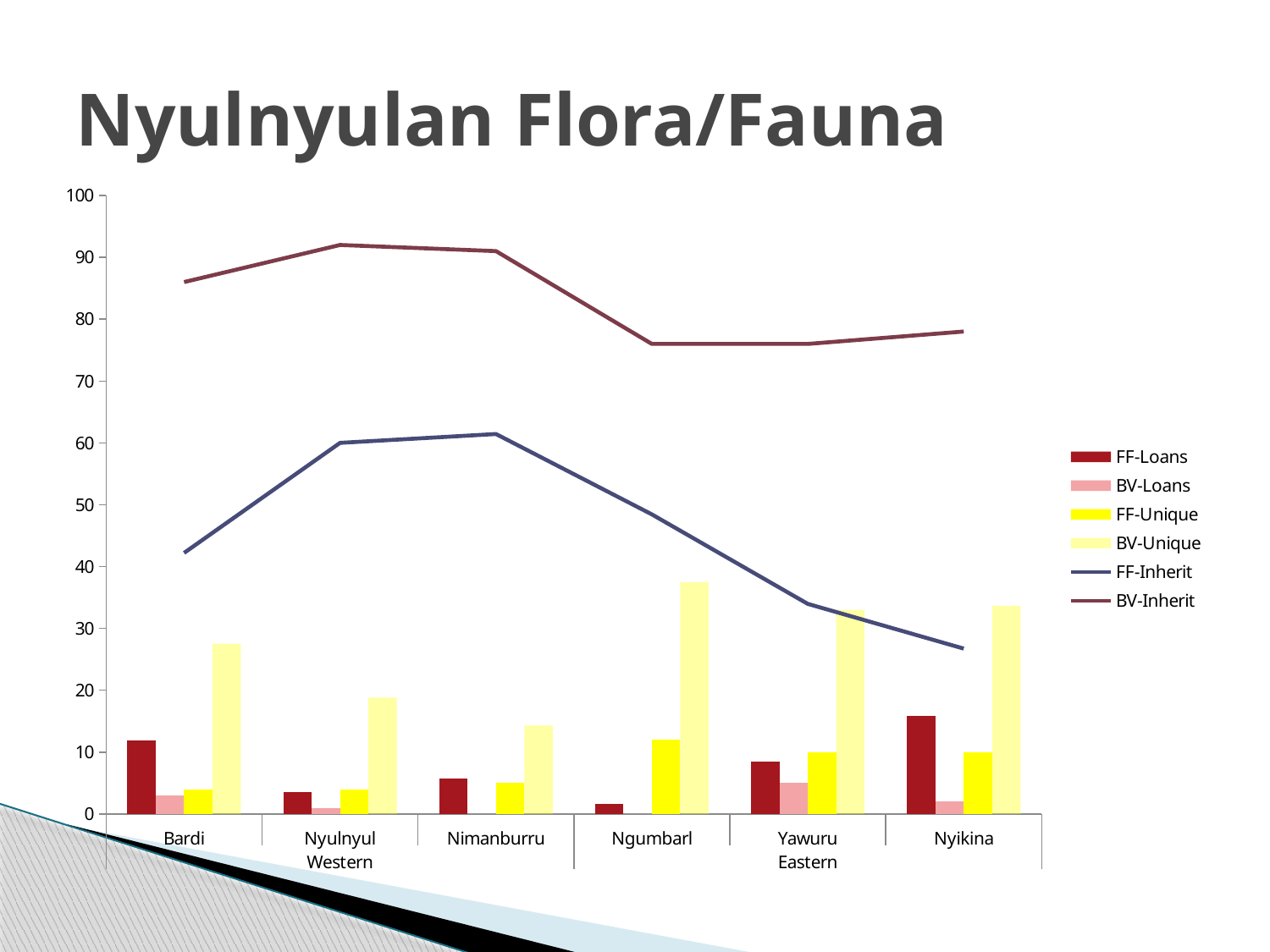
Which category has the highest BV-Unique bar? Ngumbarl Is the FF-Inherit value for Nyikina greater or less than 30? less Which category has the highest FF-Loans bar? Nyikina How many series does the legend list? 6 Is the BV-Unique value for Bardi greater or less than 20? greater Does the BV-Inherit line rise or fall from Nimanburru to Ngumbarl? It falls What kind of chart is this? A combined bar and line chart How many language categories are shown along the x axis? 6 Which category has the lowest FF-Loans bar? Ngumbarl Is the BV-Inherit value for Nyulnyul greater or less than 80? greater At Bardi, which is larger: the BV-Inherit value or the FF-Inherit value? BV-Inherit Which category has the lowest FF-Inherit value? Nyikina